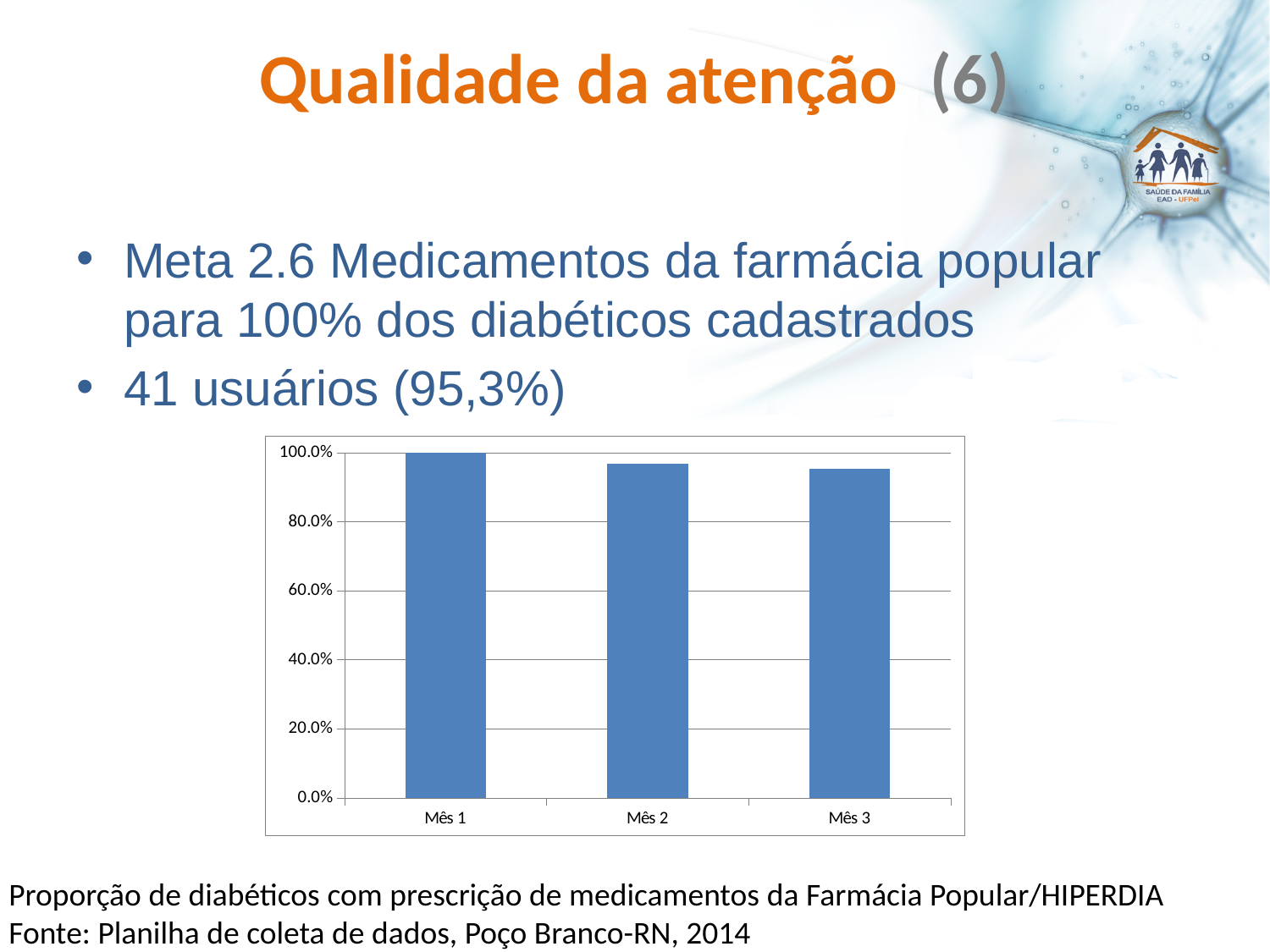
Is the value for Mês 3 greater or less than 80.0%? greater Do the values rise or fall from Mês 1 to Mês 3? fall Which month has the highest value in the chart? Mês 1 Which is larger, the value for Mês 1 or the value for Mês 3? Mês 1 How many categories (months) are shown on the x axis of the chart? 3 What kind of chart is shown on the slide? bar chart What is the value for Mês 1 in the chart? 100.0% What is the highest tick value shown on the y axis of the chart? 100.0% Is the value for Mês 2 greater or less than 80.0%? greater What is the label of the first category on the x axis? Mês 1